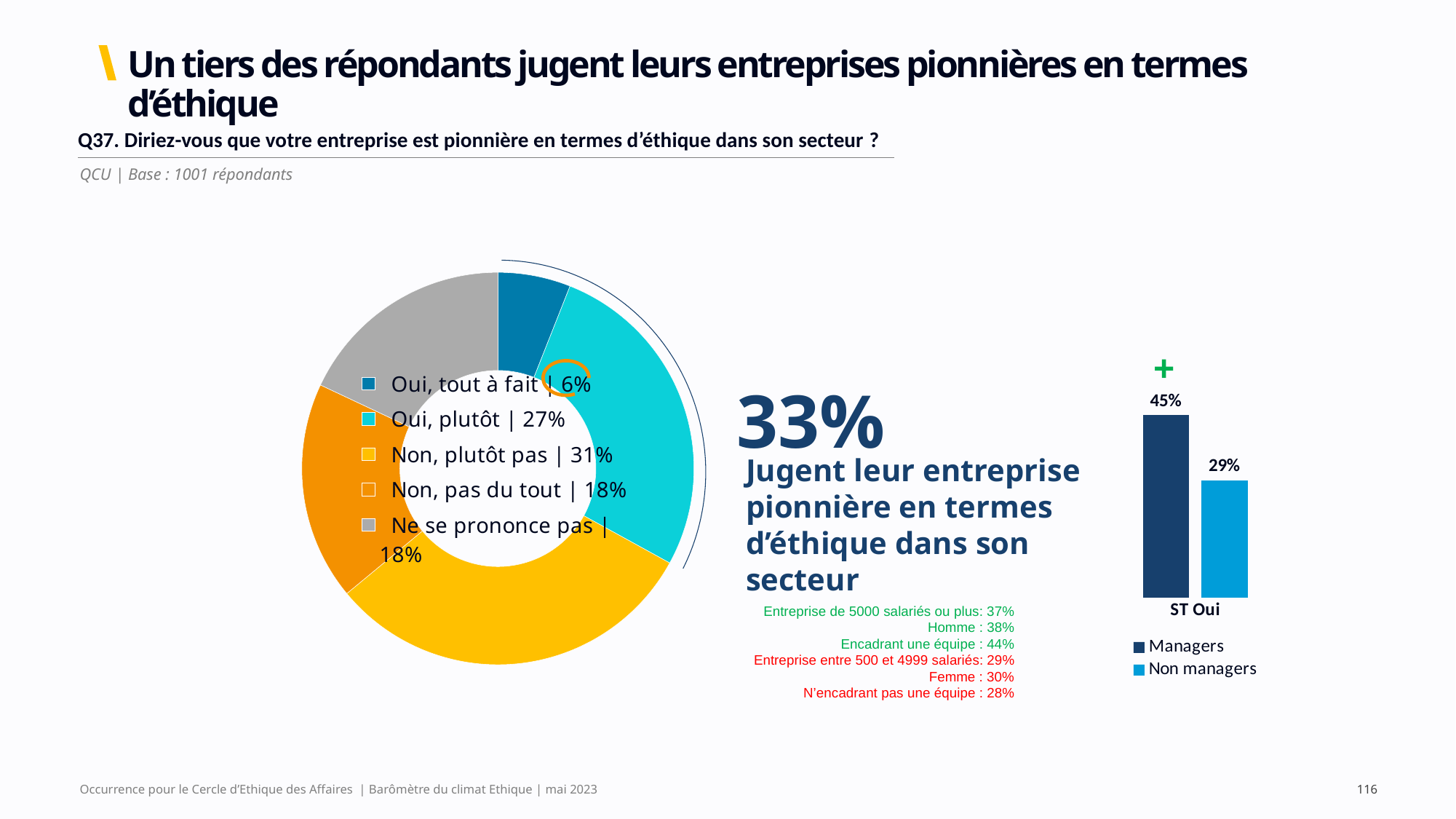
In the donut chart, what share of respondents answered "Oui, plutôt"? 27% In the donut chart, which response category has the largest share? Non, plutôt pas In the bar chart on the right (ST Oui), what is the value for Non managers? 29% In the bar chart on the right (ST Oui), what is the difference between Managers and Non managers? 16 points In the donut chart, what is the difference between the shares for "Non, plutôt pas" and "Oui, plutôt"? 4 points In the donut chart, what share of respondents answered "Oui, tout à fait"? 6% In the donut chart, what share of respondents answered "Non, plutôt pas"? 31% In the donut chart, how many response categories are shown in the legend? 5 What type of chart is shown on the right of the slide for ST Oui? Bar chart In the donut chart, which is larger: the share for "Oui, plutôt" or the share for "Non, pas du tout"? Oui, plutôt In the donut chart, which response category has the smallest share? Oui, tout à fait In the bar chart on the right (ST Oui), what is the value for Managers? 45%